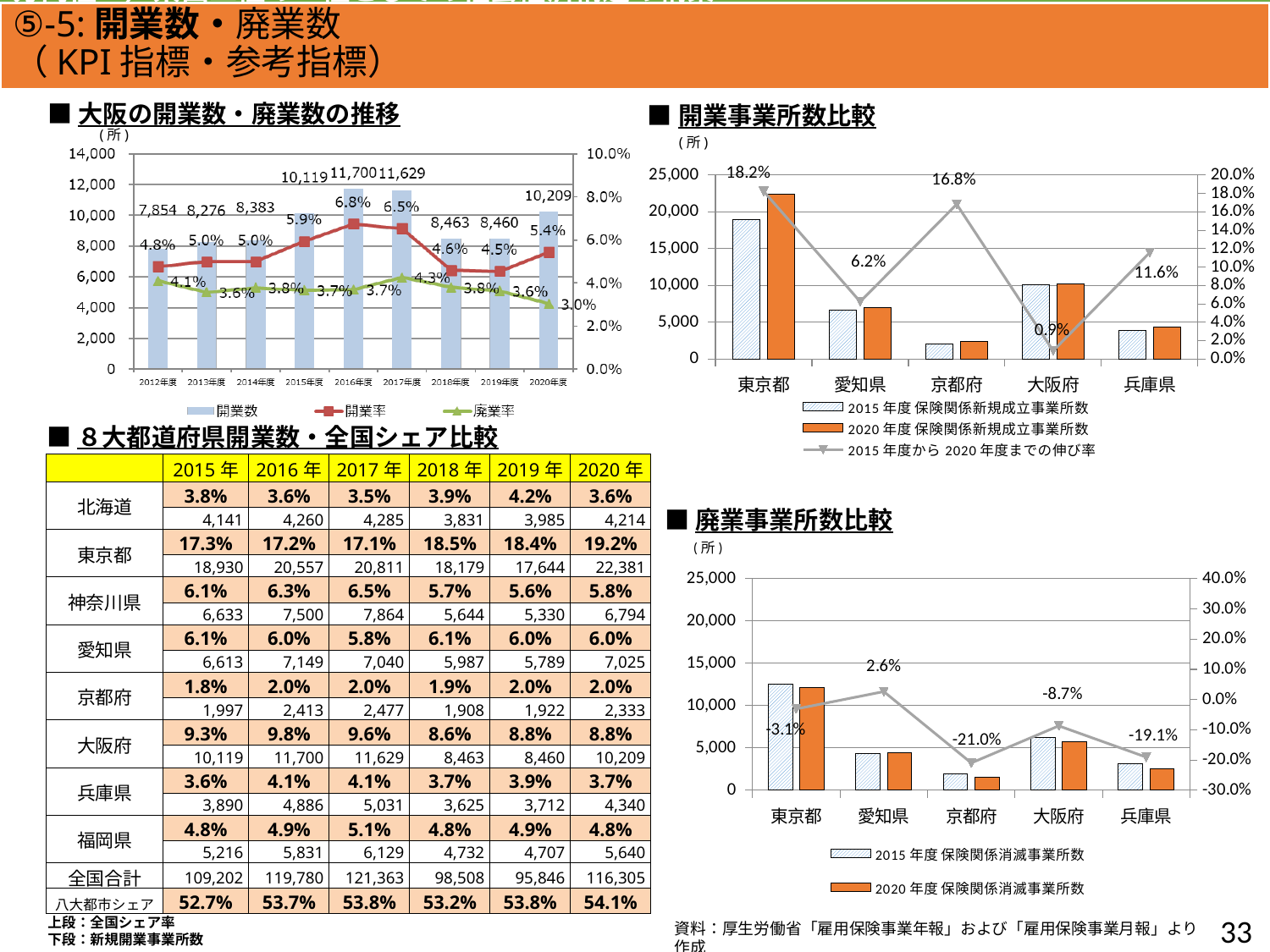
In the chart titled 開業事業所数比較, what is the 2015年度から2020年度までの伸び率 for 京都府? 16.8% What kind of chart is the one titled 大阪の開業数・廃業数の推移? Combination bar and line chart In the chart titled 大阪の開業数・廃業数の推移, which year has the highest 開業率? 2016年度 In the chart titled 大阪の開業数・廃業数の推移, which year has the lowest 廃業率? 2020年度 In the chart titled 廃業事業所数比較, what is the rate shown for 京都府? -21.0% In the chart titled 廃業事業所数比較, which prefecture has the lowest rate on the line? 京都府 In the chart titled 開業事業所数比較, is the 2020年度 bar for 東京都 greater or less than 20,000? greater In the chart titled 開業事業所数比較, which prefecture has the highest 伸び率? 東京都 In the chart titled 廃業事業所数比較, how many prefectures are shown on the x axis? 5 In the chart titled 大阪の開業数・廃業数の推移, what is the 開業数 value for 2016年度? 11,700 In the chart titled 大阪の開業数・廃業数の推移, what is the difference between the 開業数 for 2017年度 and 2018年度? 3,166 In the chart titled 大阪の開業数・廃業数の推移, how many series does the legend list? 3